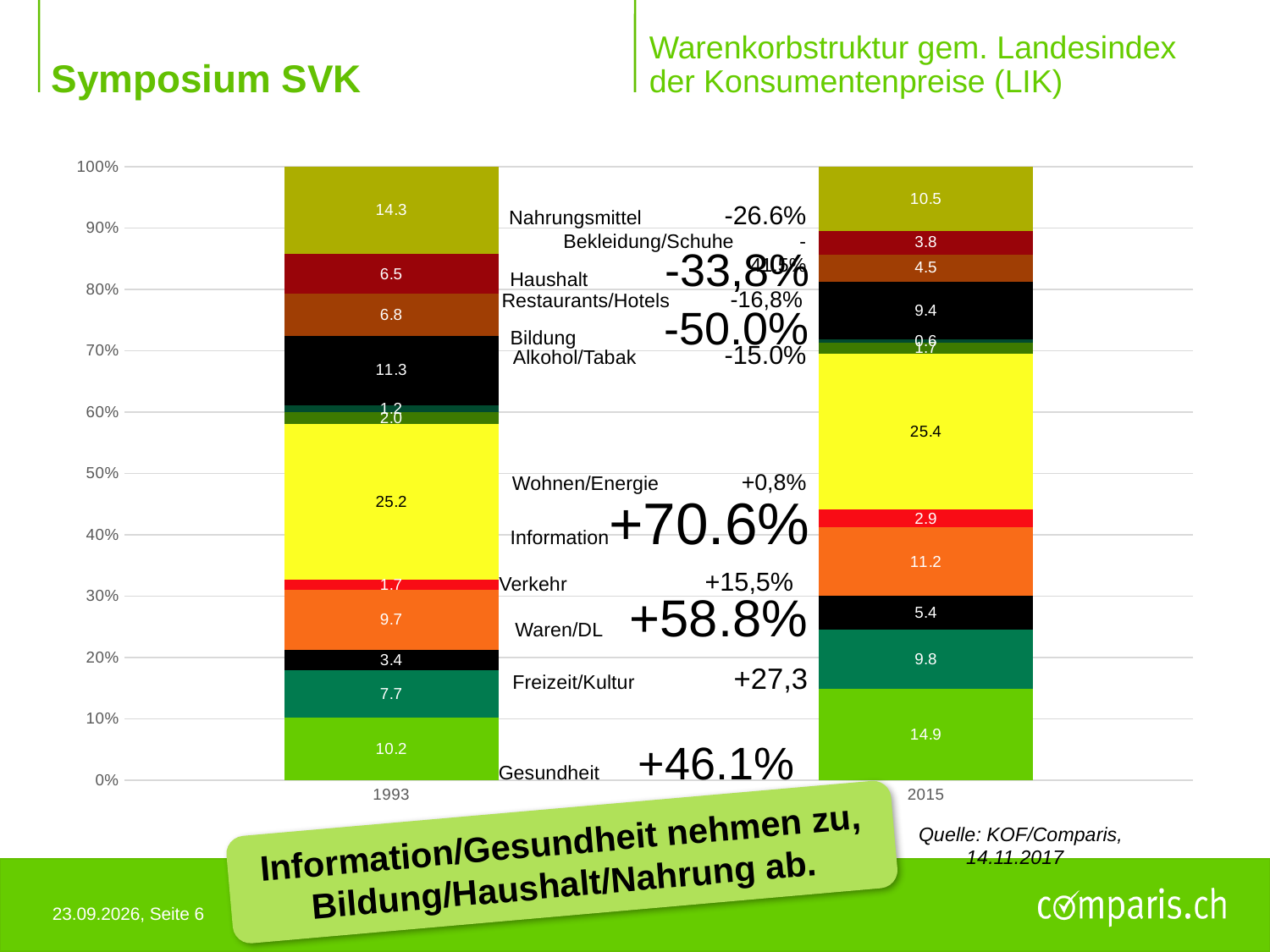
What is the value of the bottom (green, Gesundheit) segment of the 2015 bar? 14.9 What kind of chart is shown on the slide? Stacked bar chart Which two years are labelled on the x axis? 1993 and 2015 What percentage change is shown for Information between 1993 and 2015? +70.6% Which year has the larger Freizeit/Kultur (dark green) segment, 1993 or 2015? 2015 What is the value of the top segment (Nahrungsmittel) of the 2015 bar? 10.5 How many bars (years) are plotted on the x axis? 2 What is the value of the largest segment (yellow, Wohnen/Energie) in the 1993 bar? 25.2 What percentage change is shown for Bildung between 1993 and 2015? -50.0% By how much is the bottom (Gesundheit) segment of the 2015 bar larger than that of the 1993 bar? 4.7 What is the value of the bottom (green, Gesundheit) segment of the 1993 bar? 10.2 By how much is the top (Nahrungsmittel) segment of the 1993 bar larger than that of the 2015 bar? 3.8